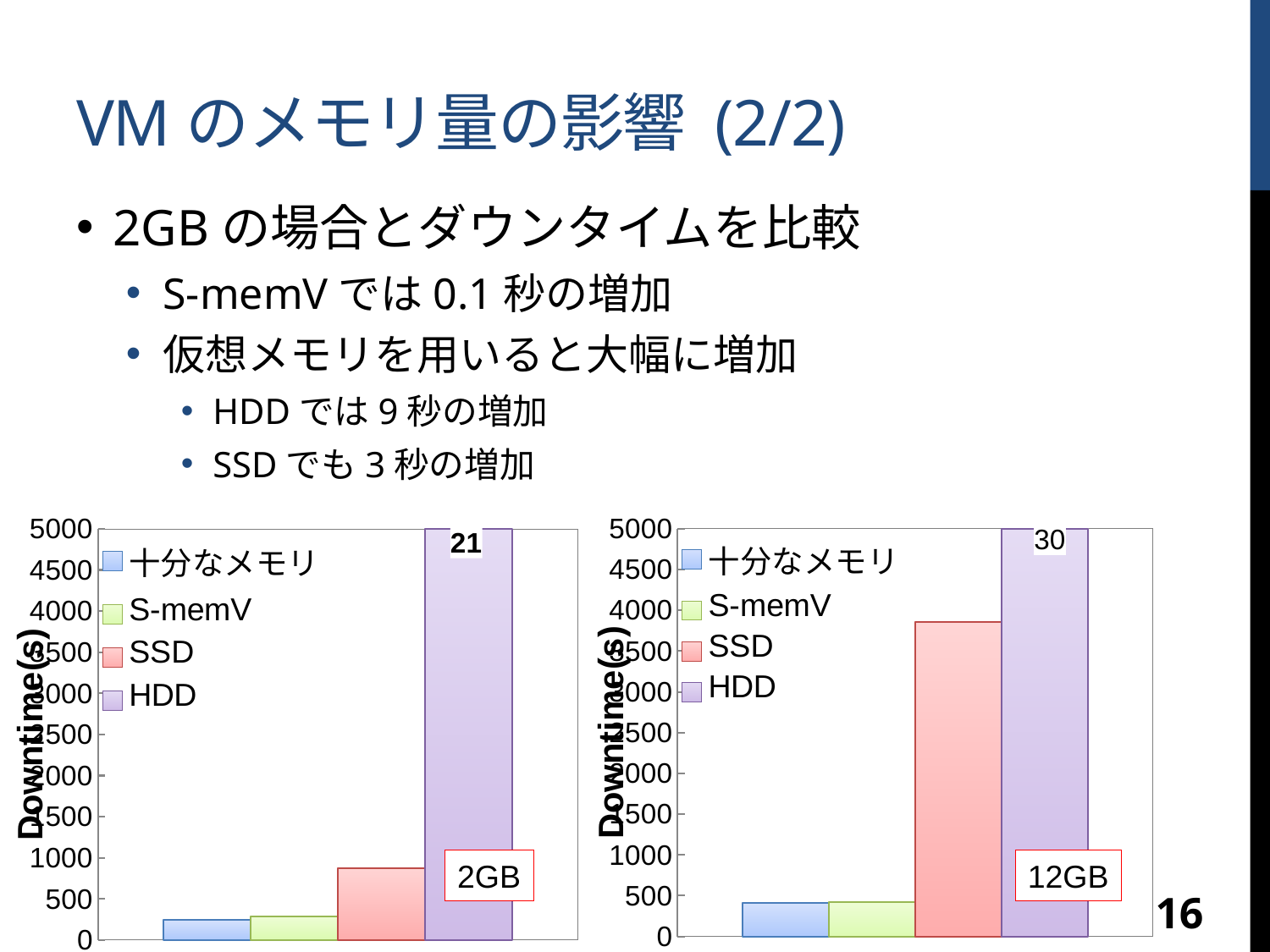
In the right chart labelled 12GB, which series has the highest downtime? HDD In the right chart labelled 12GB, which is larger, the value for SSD or the value for 十分なメモリ? SSD What is the y-axis label of the left chart labelled 2GB? Downtime (s) What kind of chart is the left chart labelled 2GB? bar chart In the right chart labelled 12GB, is the value for S-memV greater or less than 500? less In the right chart labelled 12GB, is the value for SSD greater or less than 3500? greater In the left chart labelled 2GB, is the value for SSD greater or less than 1000? less How many series does the legend of the right chart labelled 12GB list? 4 In the left chart labelled 2GB, which is larger, the value for SSD or the value for S-memV? SSD In the left chart labelled 2GB, which series has the lowest downtime? 十分なメモリ In the left chart labelled 2GB, which series has the highest downtime? HDD How many bars are plotted in the right chart labelled 12GB? 4